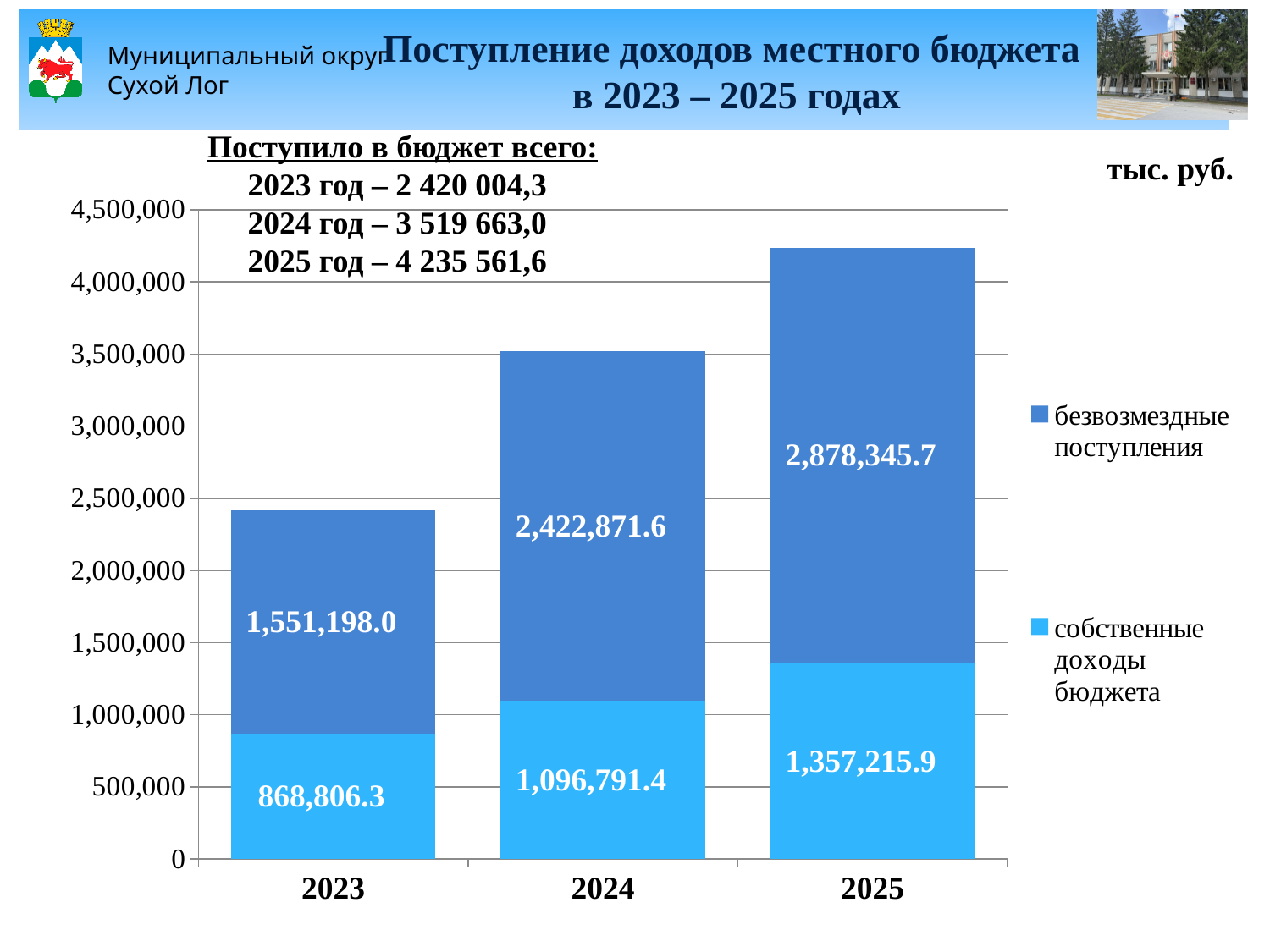
What is the value of безвозмездные поступления for 2024? 2,422,871.6 How many years are shown on the x axis of the chart? 3 Which year has the lowest value of безвозмездные поступления? 2023 What is the difference between собственные доходы бюджета in 2025 and in 2024? 260,424.5 Which year has the highest value of собственные доходы бюджета? 2025 What is the total of the stacked bar for 2024? 3,519,663.0 What is the value of собственные доходы бюджета for 2023? 868,806.3 How many series does the legend list? 2 What is the value of безвозмездные поступления for 2025? 2,878,345.7 What is the total of the stacked bar for 2025? 4,235,561.6 What kind of chart is shown on the slide? Stacked bar chart Which is larger: безвозмездные поступления in 2023 or собственные доходы бюджета in 2025? безвозмездные поступления in 2023